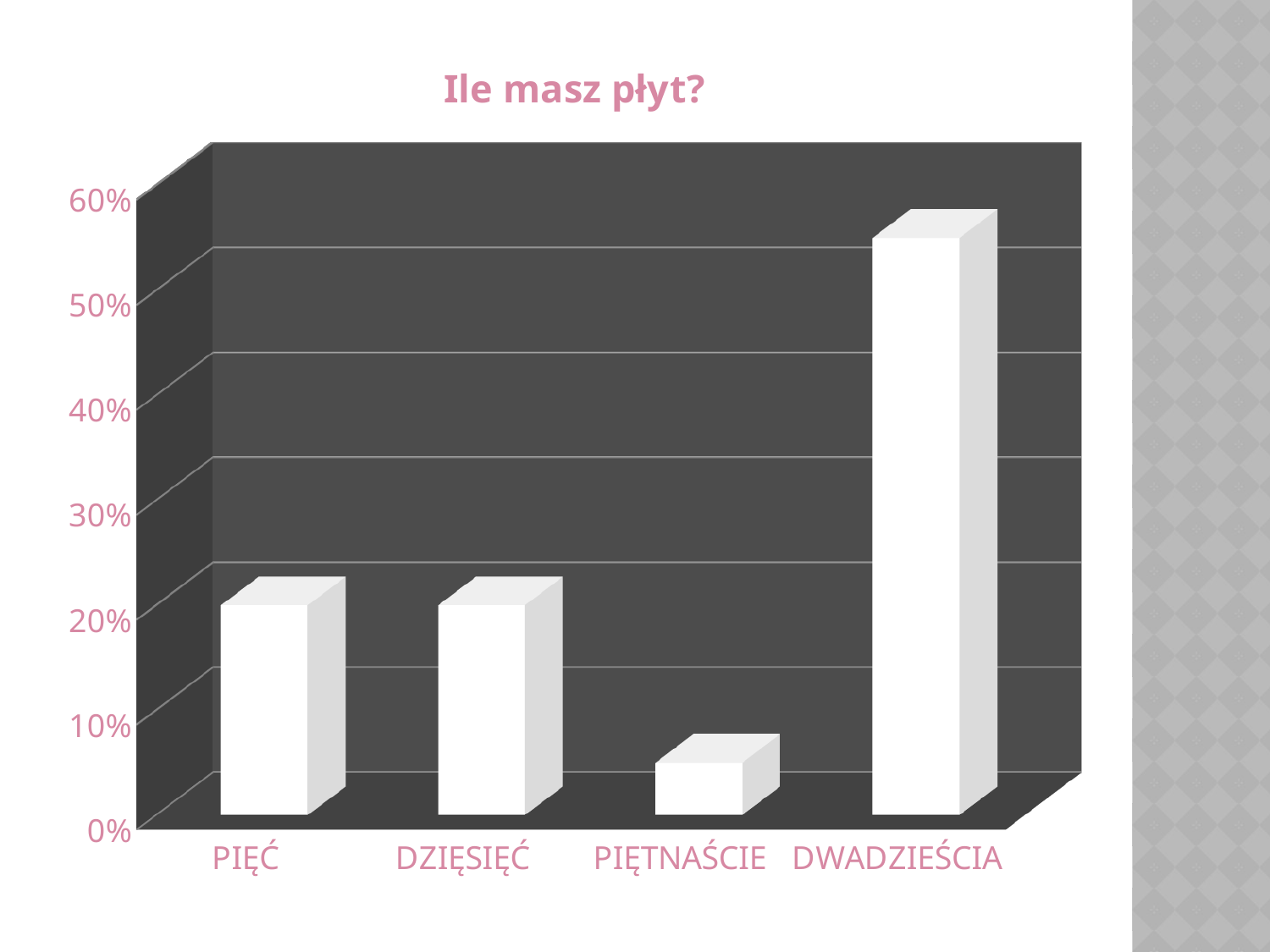
Which category has the highest value? DWADZIEŚCIA Is the value for DWADZIEŚCIA greater or less than 50%? greater Is the value for PIĘĆ greater or less than 30%? less What is the highest value shown on the vertical axis? 60% Is the value for DZIĘSIĘĆ greater or less than 30%? less Which is larger, the value for DWADZIEŚCIA or the value for PIĘĆ? DWADZIEŚCIA What kind of chart is shown on the slide? bar chart What is the title of the chart? Ile masz płyt? Which is larger, the value for PIĘĆ or the value for PIĘTNAŚCIE? PIĘĆ Which category has the lowest value? PIĘTNAŚCIE How many categories are shown on the x axis of the chart? 4